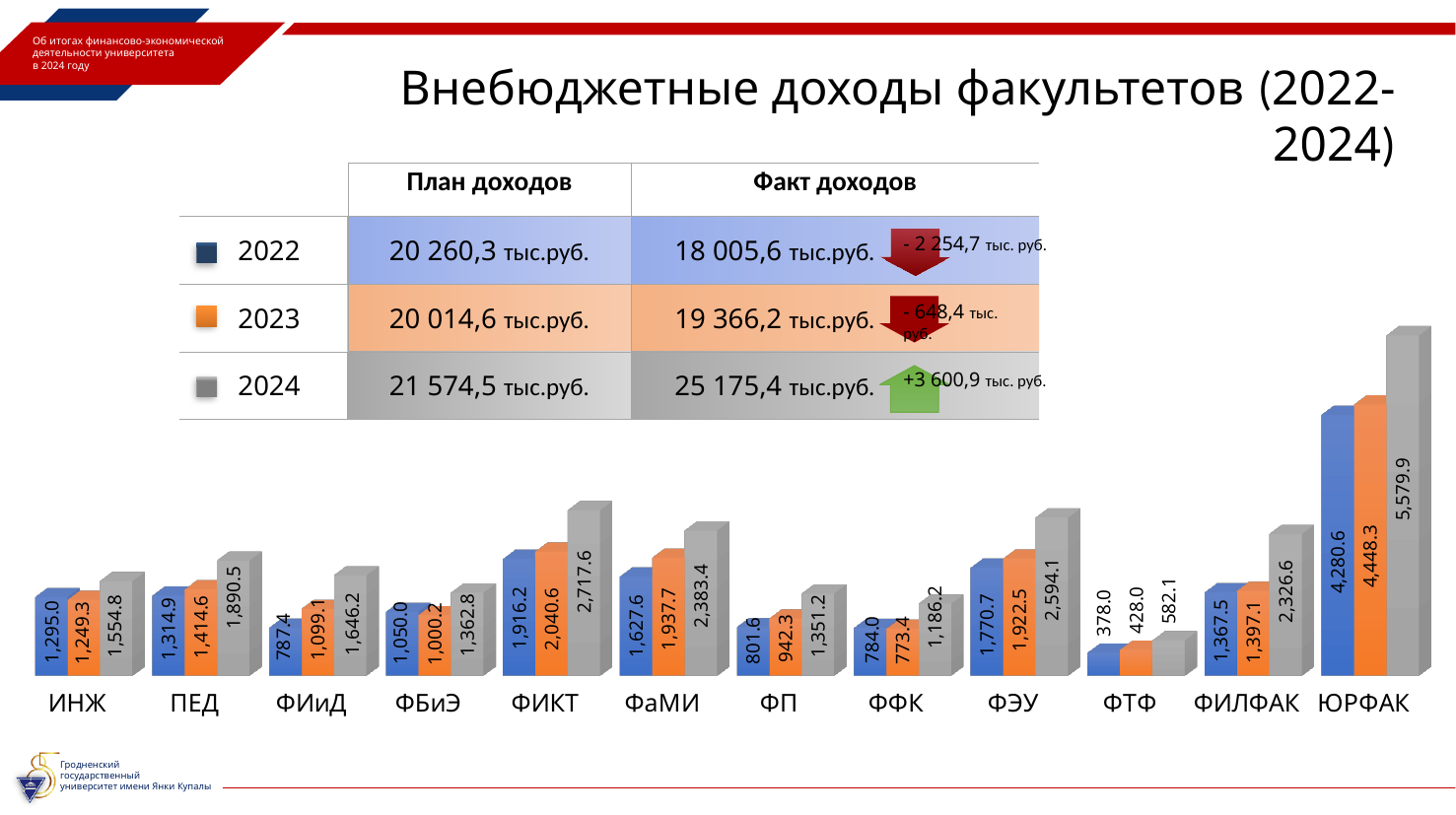
Do the values for ФИиД rise or fall from 2022 to 2024? Rise What is the 2022 value for ФИКТ? 1,916.2 How many series (years) does the chart show? 3 Which faculty has the lowest 2022 value? ФТФ How many faculties are shown on the x axis of the chart? 12 Which faculty has the highest 2024 value? ЮРФАК What is the difference between the 2024 and 2022 values for ПЕД? 575.6 What is the 2023 value for ФТФ? 428.0 Which is larger for ФФК: the 2022 value or the 2023 value? 2022 value What is the 2024 value for ЮРФАК? 5,579.9 Which colour represents the year 2023 in the chart? Orange What kind of chart is shown on the slide? Bar chart